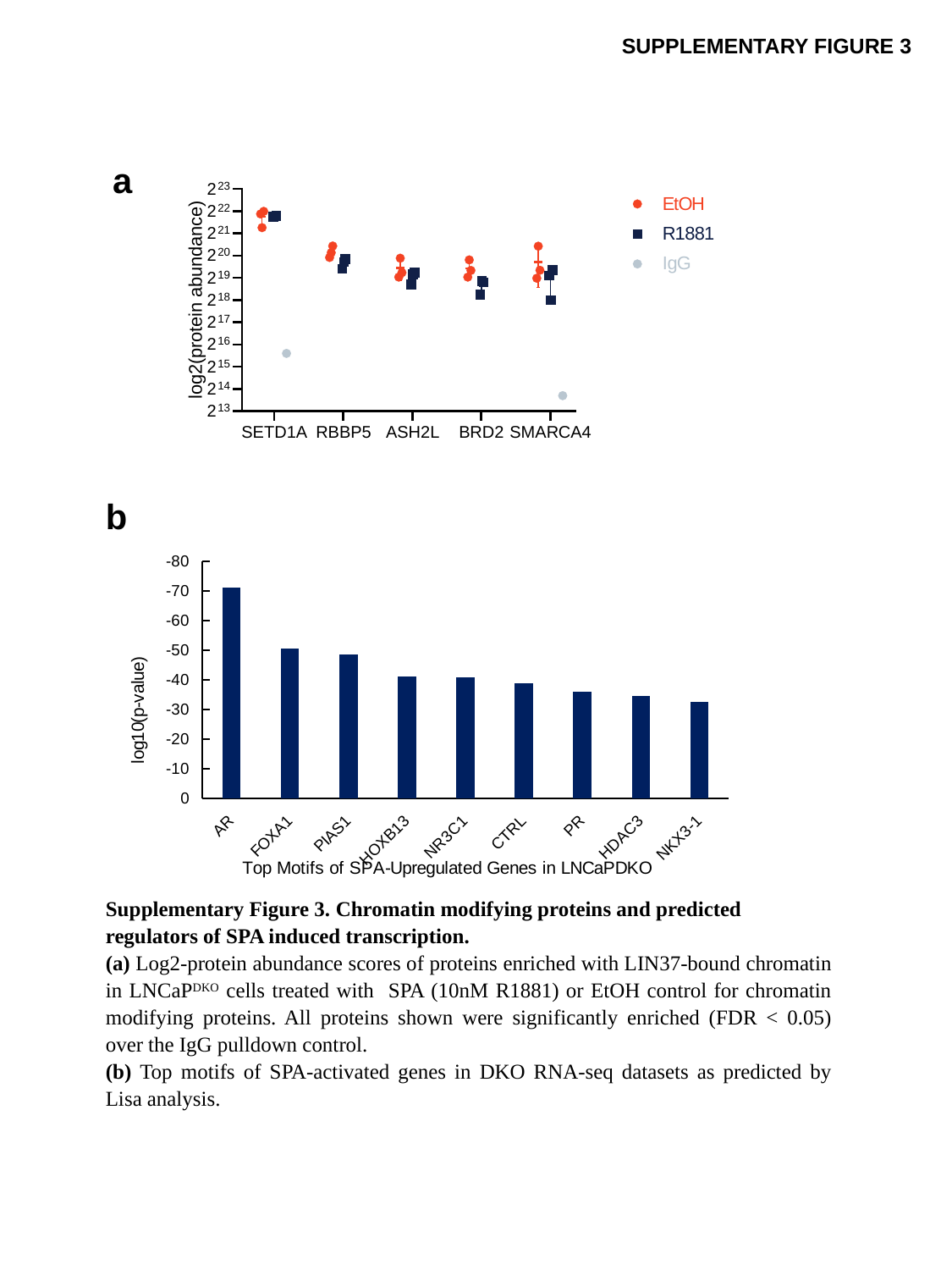
In panel a, is the IgG value for SETD1A greater or less than 2^16? less In panel b, which bar is taller, AR or FOXA1? AR In panel b, how many motifs are shown on the x axis? 9 In panel b, what is the x-axis title? Top Motifs of SPA-Upregulated Genes in LNCaPDKO In panel b, which motif has the shortest bar (log10(p-value) closest to 0)? NKX3-1 What kind of chart is panel b? bar chart In panel a, which protein has the highest log2(protein abundance) values? SETD1A In panel a, how many series does the legend list? 3 In panel b, which motif has the tallest bar (most negative log10(p-value))? AR In panel a, which series is shown in grey in the legend? IgG In panel b, do the bar heights increase or decrease from left to right along the x axis? decrease In panel a, how many proteins are shown on the x axis? 5